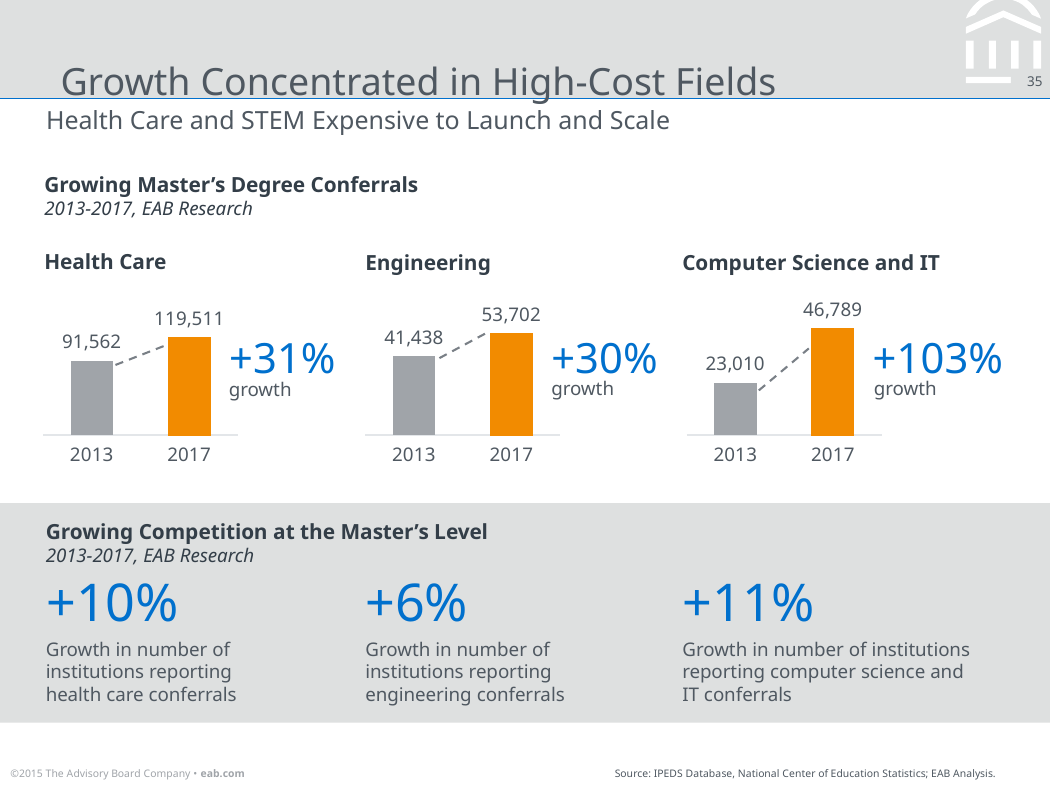
In the Health Care chart, what is the value for 2017? 119,511 How many bars are shown in the Health Care chart? 2 What kind of chart is used for the Engineering data? Bar chart In the Computer Science and IT chart, which year has the lowest value? 2013 In the Engineering chart, what is the difference between the 2017 and 2013 values? 12,264 What growth percentage is shown next to the Computer Science and IT chart? +103% In the Health Care chart, what is the value for 2013? 91,562 In the Engineering chart, what is the value for 2013? 41,438 In the Engineering chart, do the values rise or fall from 2013 to 2017? Rise In the Computer Science and IT chart, what is the value for 2017? 46,789 In the Health Care chart, which year has the higher value, 2013 or 2017? 2017 In the Computer Science and IT chart, what is the difference between the 2017 and 2013 values? 23,779